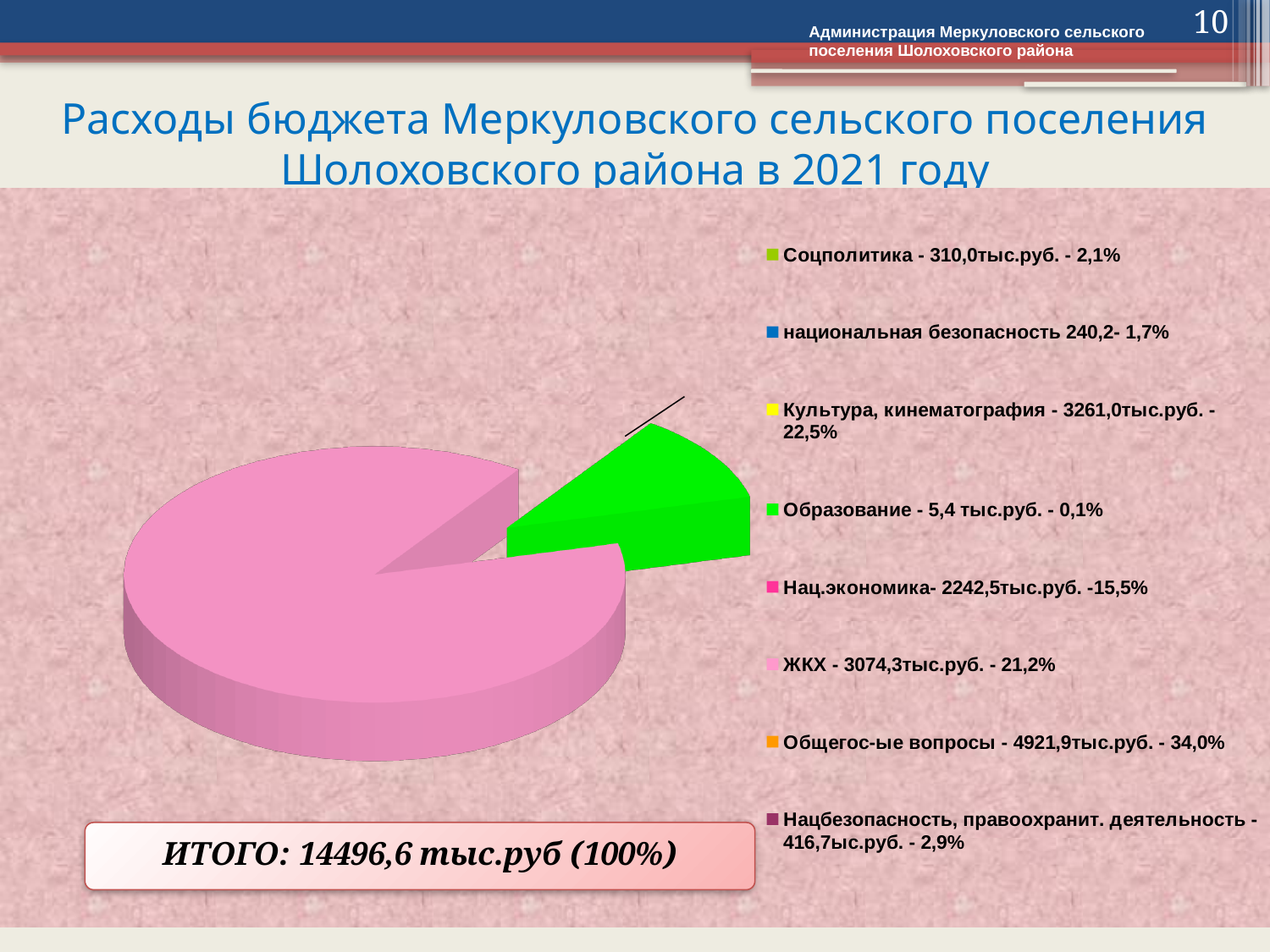
How many categories does the chart legend list? 8 What amount is shown for Культура, кинематография? 3261,0тыс.руб. What kind of chart is shown on the slide? pie chart What amount is shown for ЖКХ? 3074,3тыс.руб. Which category has the largest share of expenditure? Общегос-ые вопросы What percentage share is shown for Общегос-ые вопросы? 34,0% Which is larger: the amount for Нац.экономика or for ЖКХ? ЖКХ What is the difference in percentage share between Культура, кинематография and ЖКХ? 1,3% What is the total budget expenditure shown on the slide (ИТОГО)? 14496,6 тыс.руб (100%) Which category has the smallest share of expenditure? Образование What percentage share is shown for Образование? 0,1% What is the title of the chart slide? Расходы бюджета Меркуловского сельского поселения Шолоховского района в 2021 году